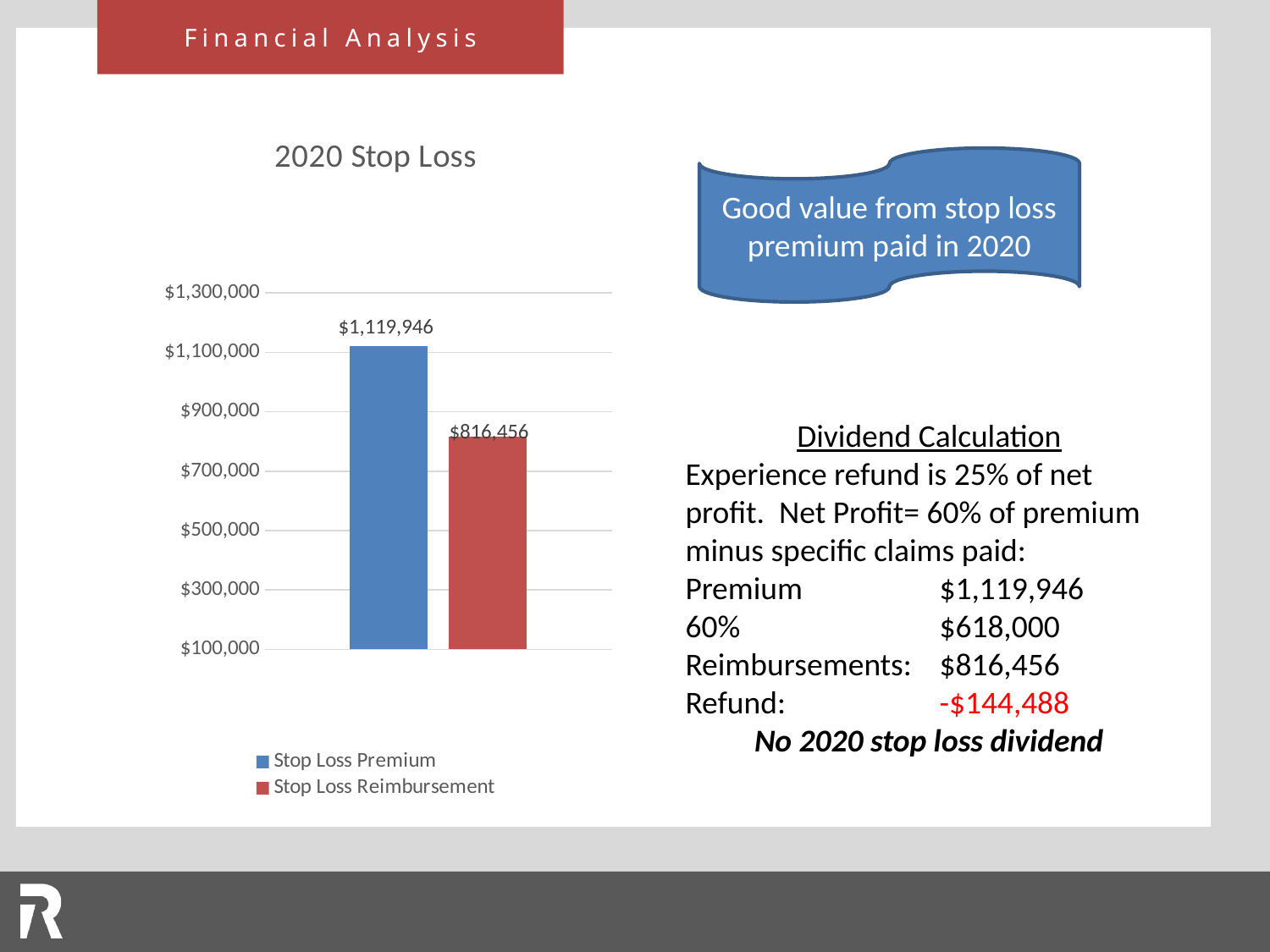
What is the value of the Stop Loss Reimbursement bar in the 2020 Stop Loss chart? $816,456 What is the difference between the Stop Loss Premium and the Stop Loss Reimbursement in the 2020 Stop Loss chart? $303,490 Which series has the lower value in the 2020 Stop Loss chart? Stop Loss Reimbursement Is the value for Stop Loss Premium greater or less than $1,100,000? greater What kind of chart is the 2020 Stop Loss chart? bar chart How many bars are plotted in the 2020 Stop Loss chart? 2 How many series does the legend of the 2020 Stop Loss chart list? 2 What is the value of the Stop Loss Premium bar in the 2020 Stop Loss chart? $1,119,946 What colour is the Stop Loss Reimbursement bar in the 2020 Stop Loss chart? red Which series has the higher value in the 2020 Stop Loss chart? Stop Loss Premium Is the Stop Loss Premium larger or smaller than the Stop Loss Reimbursement in the 2020 Stop Loss chart? larger Is the value for Stop Loss Reimbursement greater or less than $900,000? less